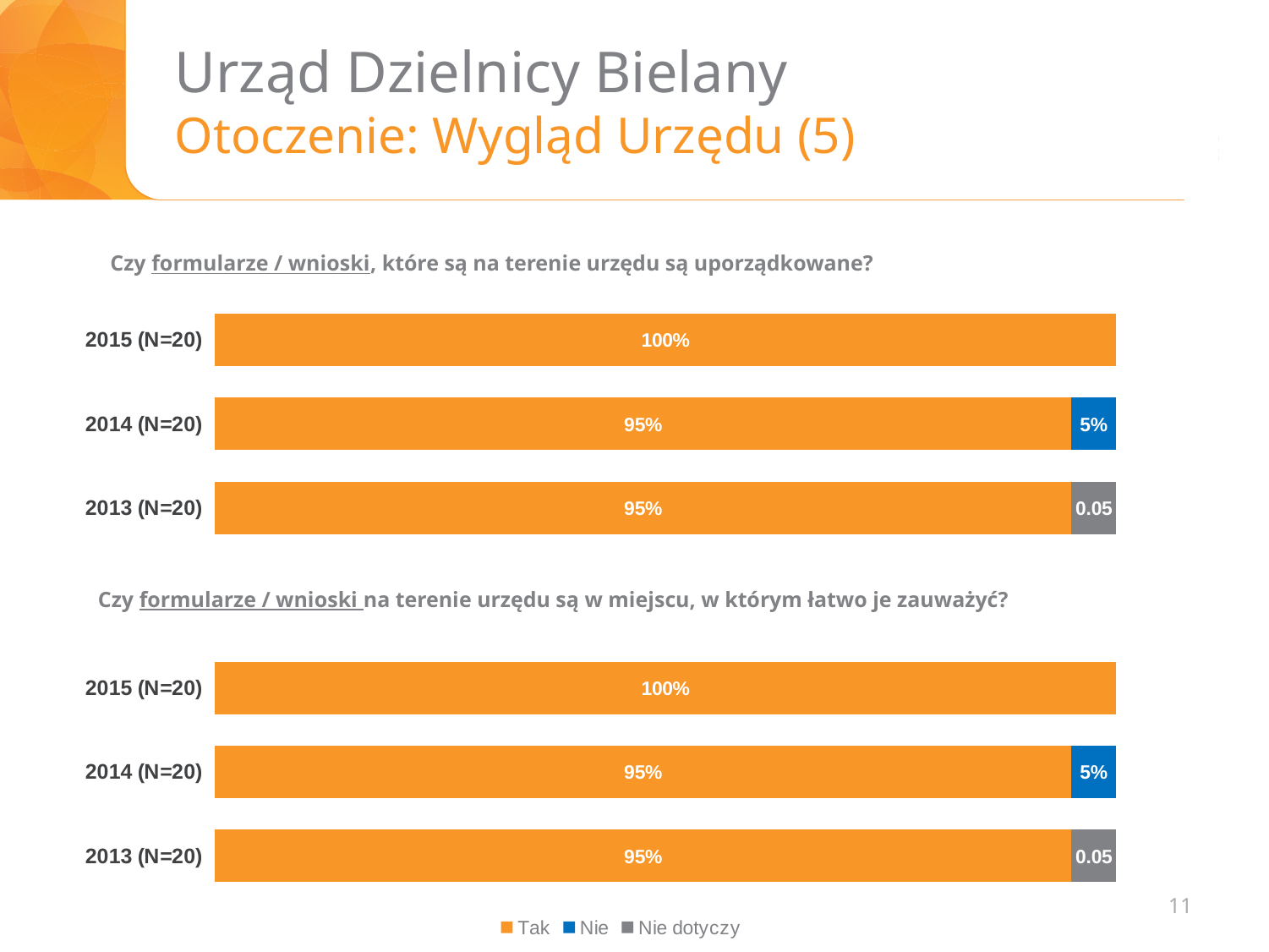
In the bottom chart ("Czy formularze / wnioski na terenie urzędu są w miejscu, w którym łatwo je zauważyć?"), what is the difference between the Tak value in 2015 (N=20) and in 2014 (N=20)? 5% In the top chart ("Czy formularze / wnioski, które są na terenie urzędu są uporządkowane?"), what is the value for Nie in 2014 (N=20)? 5% Which series is shown in orange in the legend? Tak How many series does the legend at the bottom of the slide list? 3 In the top chart ("Czy formularze / wnioski, które są na terenie urzędu są uporządkowane?"), which year has the highest Tak value? 2015 (N=20) What kind of chart is the top chart ("Czy formularze / wnioski, które są na terenie urzędu są uporządkowane?")? Stacked horizontal bar chart In the top chart ("Czy formularze / wnioski, które są na terenie urzędu są uporządkowane?"), what is the value for Tak in 2015 (N=20)? 100% In the bottom chart ("Czy formularze / wnioski na terenie urzędu są w miejscu, w którym łatwo je zauważyć?"), what is the value for Tak in 2014 (N=20)? 95% How many year categories does the bottom chart ("Czy formularze / wnioski na terenie urzędu są w miejscu, w którym łatwo je zauważyć?") show? 3 In the bottom chart ("Czy formularze / wnioski na terenie urzędu są w miejscu, w którym łatwo je zauważyć?"), what is the value for Tak in 2013 (N=20)? 95% In the top chart ("Czy formularze / wnioski, które są na terenie urzędu są uporządkowane?"), which is larger: the Tak value in 2015 (N=20) or in 2013 (N=20)? 2015 (N=20) In the top chart ("Czy formularze / wnioski, które są na terenie urzędu są uporządkowane?"), what value is printed for Nie dotyczy in 2013 (N=20)? 0.05